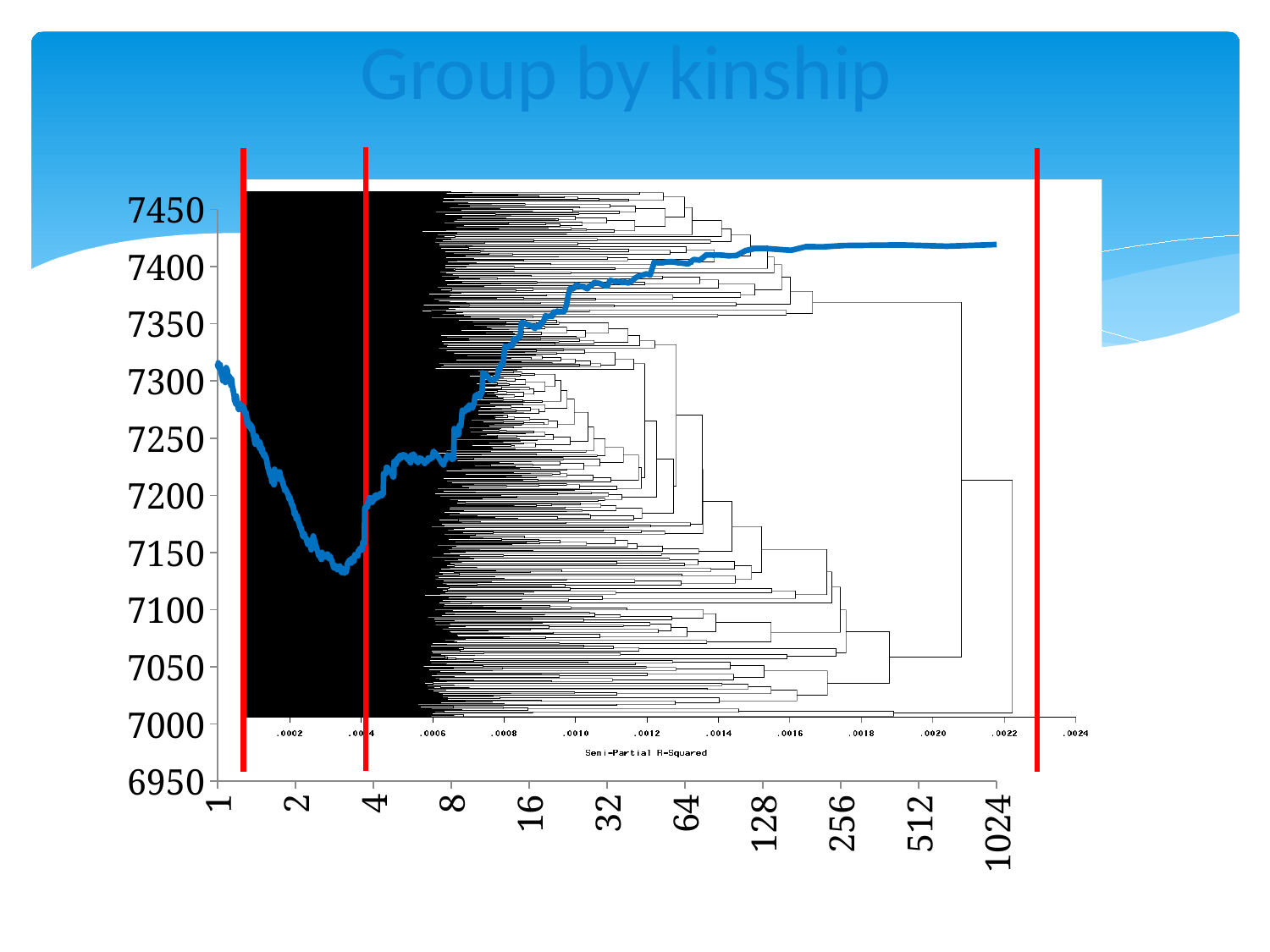
Is the value of the blue line at x = 64 greater or less than 7350? greater Is the value of the blue line at x = 1024 greater or less than 7400? greater Moving from x = 8 to x = 1024, does the blue line rise or fall? rise What kind of chart is the blue plotted series on this slide? line chart What is the title of the slide? Group by kinship What is the largest value labelled on the x axis? 1024 How many tick labels are shown on the x axis (1 through 1024)? 11 Which is larger: the value of the blue line at x = 1 or at x = 1024? x = 1024 Which is larger: the value of the blue line at x = 4 or at x = 32? x = 32 Is the value of the blue line at x = 16 greater or less than 7300? greater